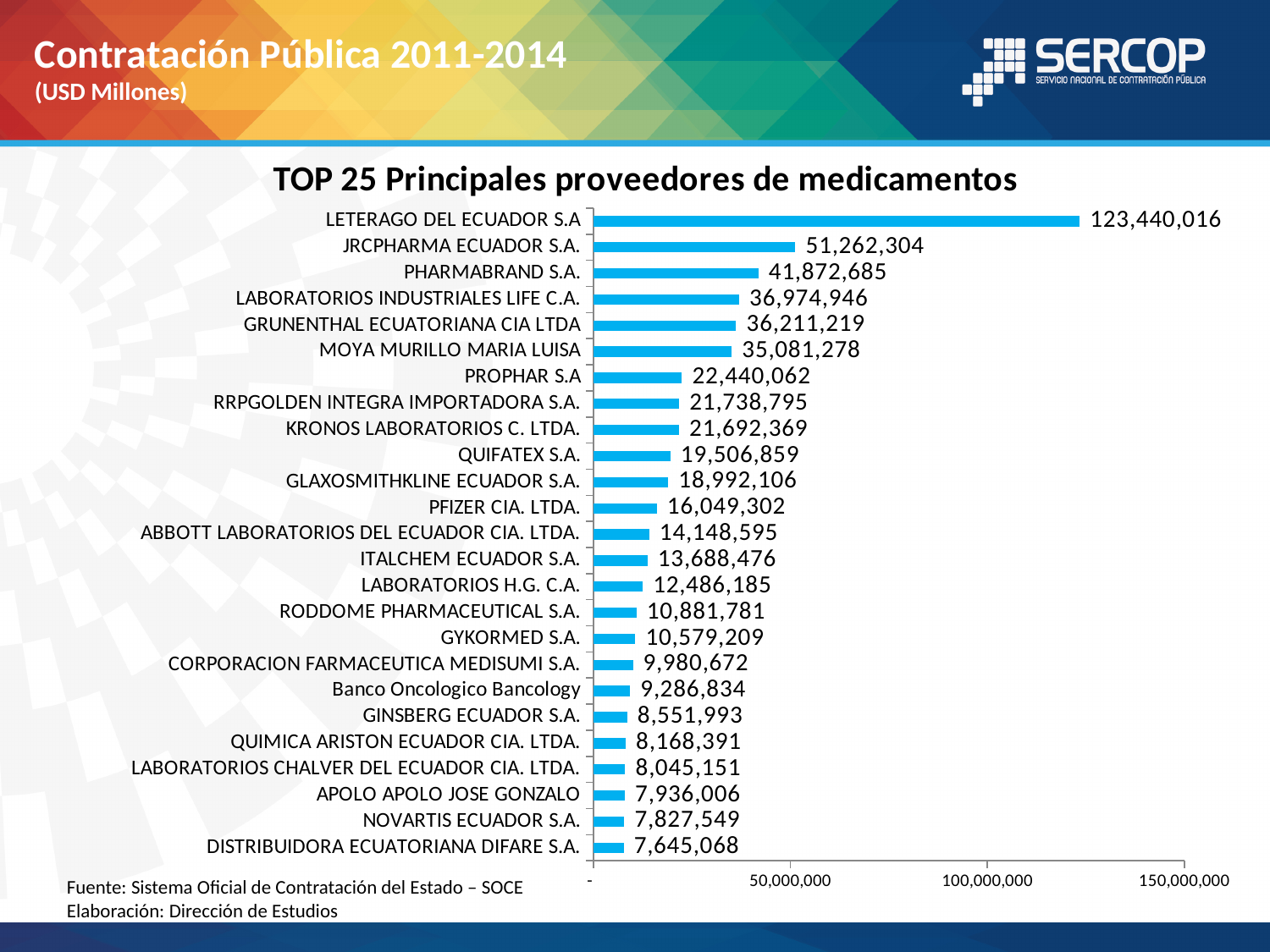
How many providers are shown in the chart? 25 What is the difference between the values for NOVARTIS ECUADOR S.A. and DISTRIBUIDORA ECUATORIANA DIFARE S.A.? 182,481 What kind of chart is shown on the slide? bar chart Which is larger, the value for PROPHAR S.A or the value for QUIFATEX S.A.? PROPHAR S.A What is the difference between the values for LETERAGO DEL ECUADOR S.A and JRCPHARMA ECUADOR S.A.? 72,177,712 What is the value for Banco Oncologico Bancology? 9,286,834 Which provider has the highest value? LETERAGO DEL ECUADOR S.A Is the value for JRCPHARMA ECUADOR S.A. greater or less than 50,000,000? greater Which provider has the lowest value? DISTRIBUIDORA ECUATORIANA DIFARE S.A. What is the title of the chart? TOP 25 Principales proveedores de medicamentos What is the value for LETERAGO DEL ECUADOR S.A? 123,440,016 What is the value for PFIZER CIA. LTDA.? 16,049,302